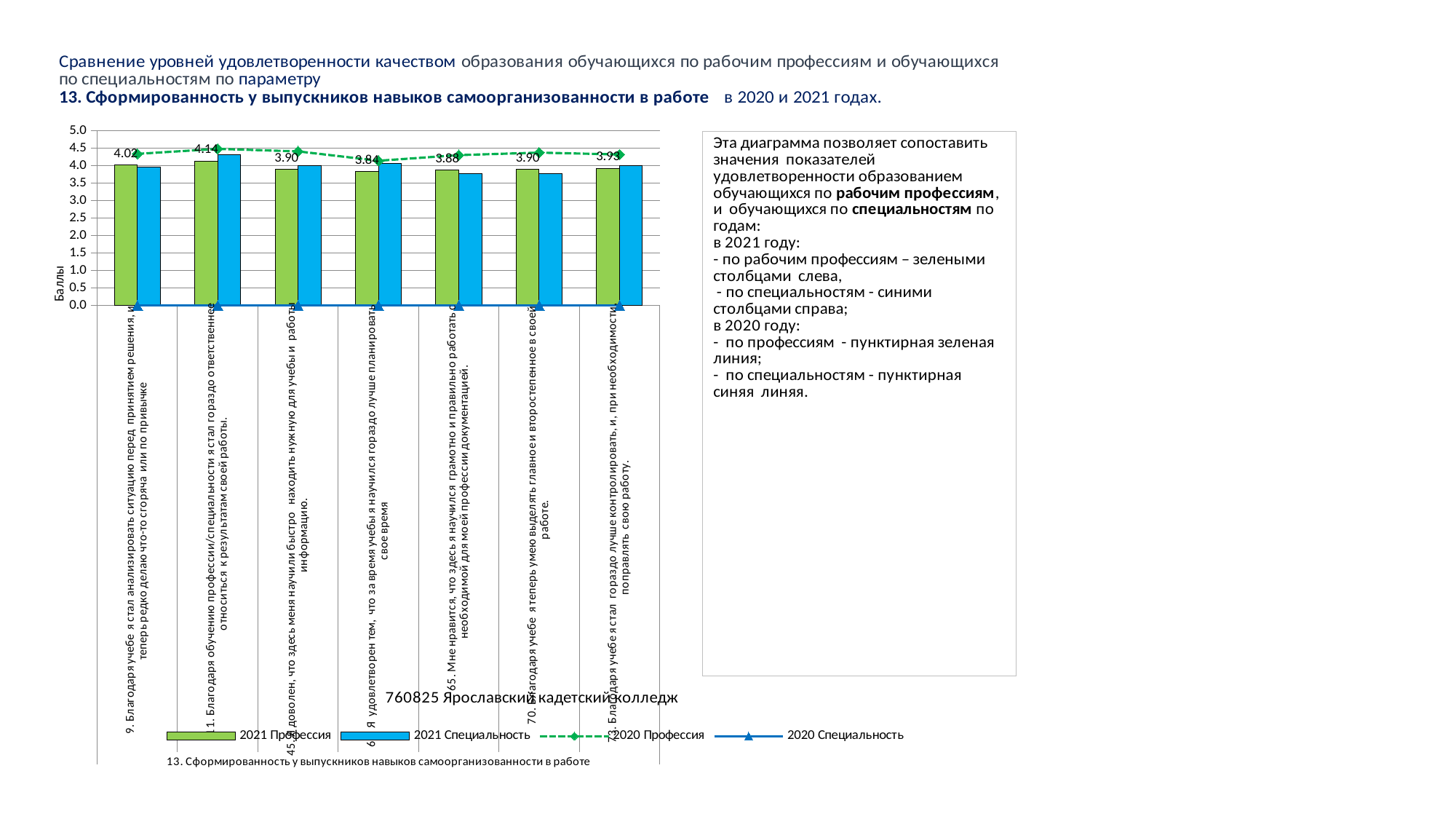
How many series does the legend list? 4 What is the 2021 Профессия value for statement 11 (Благодаря обучению профессии/специальности я стал гораздо ответственнее относиться к результатам своей работы)? 4.14 Is the 2020 Профессия value for statement 11 greater or less than 4.0? greater What kind of chart is shown on the slide? bar chart (with line series) For statement 11, which is higher: the 2021 Профессия bar or the 2021 Специальность bar? 2021 Специальность What is the difference between the highest (4.14) and lowest (3.84) labelled 2021 Профессия values? 0.30 Which statement has the lowest labelled 2021 Профессия value? Я удовлетворен тем, что за время учебы я научился гораздо лучше планировать свое время (3.84) What is the 2021 Профессия value for statement 65 (Мне нравится, что здесь я научился грамотно и правильно работать с документацией)? 3.88 What is the label on the vertical axis of the chart? Баллы What is the 2021 Профессия value for statement 9 (Благодаря учебе я стал анализировать ситуацию перед принятием решения)? 4.02 How many categories (survey statements) are plotted along the x axis? 7 Which statement has the highest labelled 2021 Профессия value? 11. Благодаря обучению профессии/специальности я стал гораздо ответственнее относиться к результатам своей работы